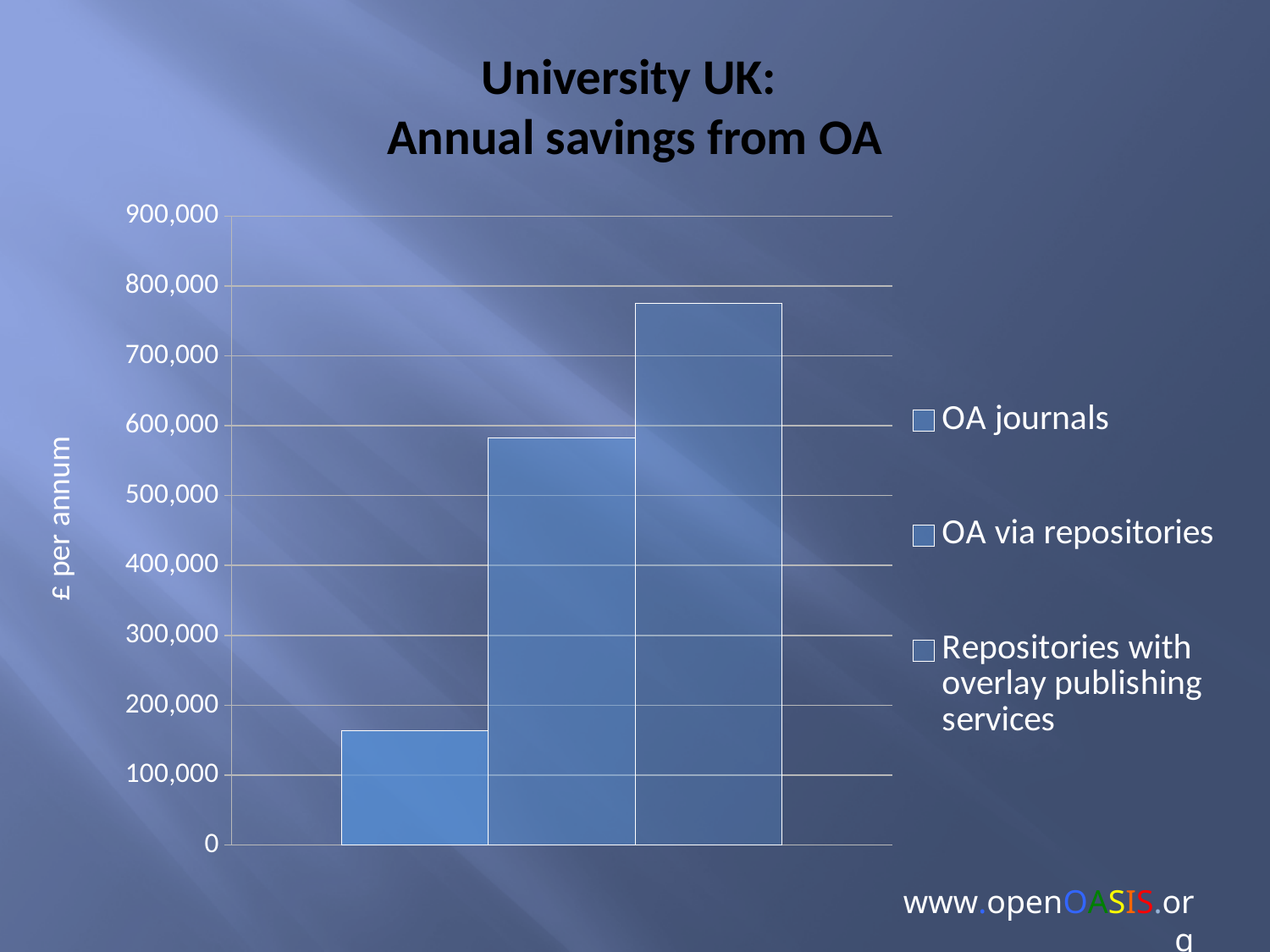
What kind of chart is shown on the slide? bar chart Is the value for Repositories with overlay publishing services greater or less than 700,000? greater Do the bar values rise or fall from left to right across the chart? rise How many bars are plotted in the chart? 3 Which series has the highest annual savings? Repositories with overlay publishing services Is the value for OA via repositories greater or less than 500,000? greater What is the label on the vertical axis? £ per annum How many series does the legend list? 3 Which is larger, the savings for OA journals or for OA via repositories? OA via repositories Which series has the lowest annual savings? OA journals What is the title of the chart? University UK: Annual savings from OA Is the value for OA journals greater or less than 200,000? less